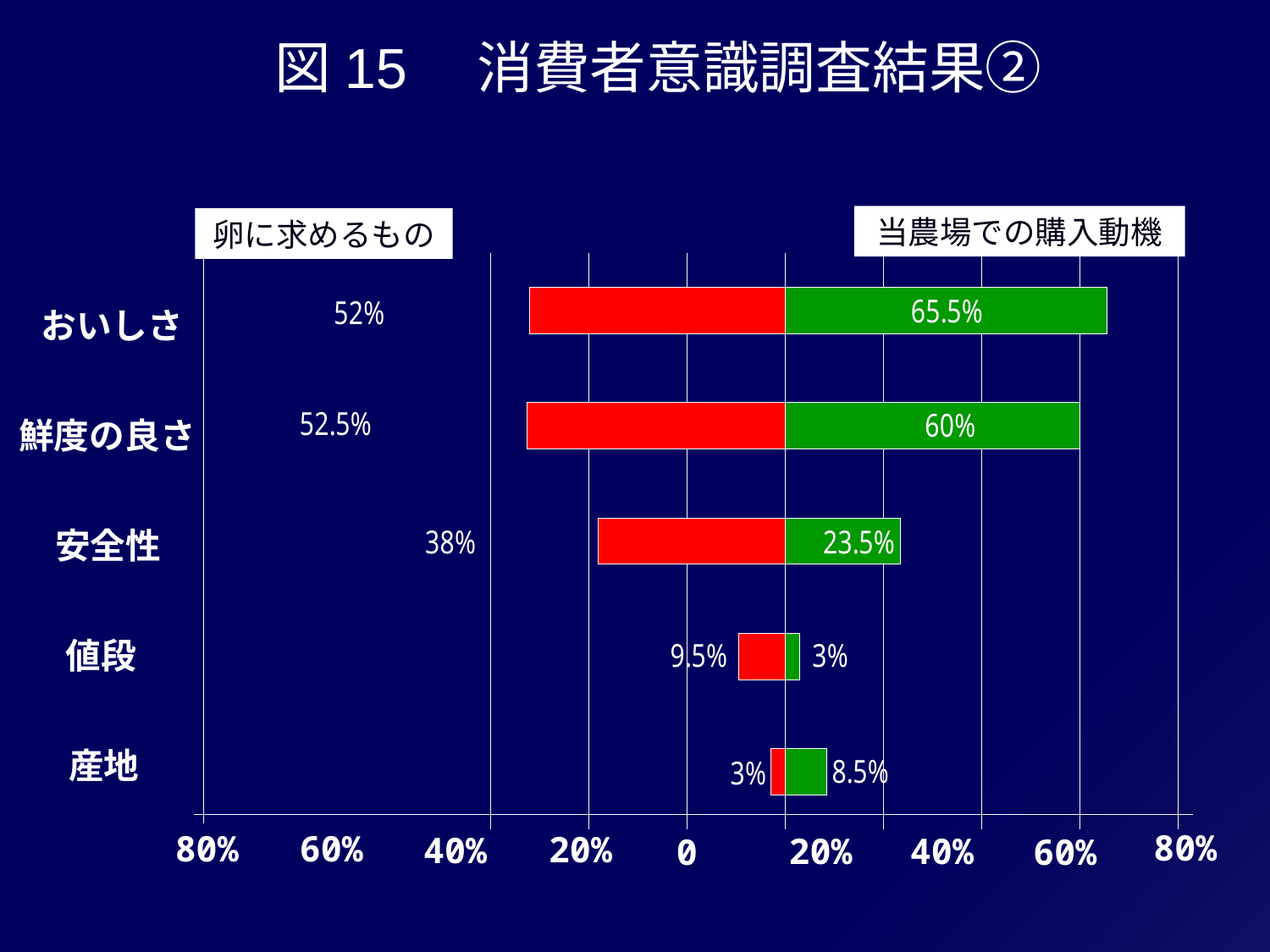
Which category has the highest value in the 当農場での購入動機 series? おいしさ What is the value for 鮮度の良さ in the 卵に求めるもの series? 52.5% How many series does the chart show? 2 Which category has the lowest value in the 卵に求めるもの series? 産地 What is the value for 産地 in the 当農場での購入動機 series? 8.5% How many categories are shown on the chart? 5 What kind of chart is shown on the slide? Bar chart What is the difference between the 当農場での購入動機 value and the 卵に求めるもの value for 安全性? 14.5% What is the value for 安全性 in the 当農場での購入動機 series? 23.5% For 値段, which series has the larger value: 卵に求めるもの or 当農場での購入動機? 卵に求めるもの What is the value for 値段 in the 卵に求めるもの series? 9.5% What is the value for おいしさ in the 当農場での購入動機 series? 65.5%